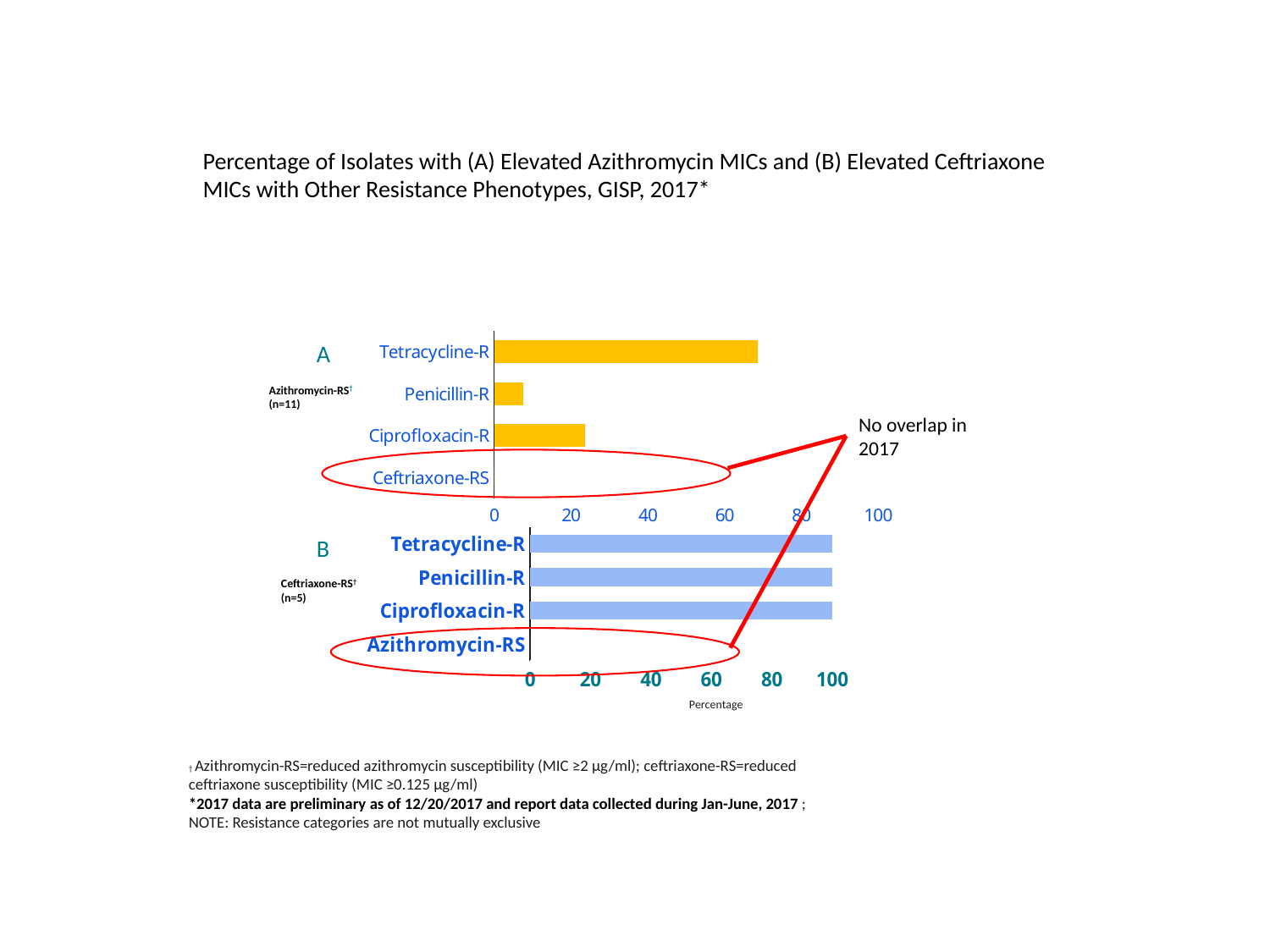
How many categories are shown in chart B (Ceftriaxone-RS)? 4 What type of chart is chart A (Azithromycin-RS)? Bar chart In chart A (Azithromycin-RS), what is the percentage for Ceftriaxone-RS? 0 What is the sample size (n) given for chart B (Ceftriaxone-RS)? n=5 In chart A (Azithromycin-RS), which category has the lowest percentage? Ceftriaxone-RS In chart A (Azithromycin-RS), which category has the highest percentage? Tetracycline-R In chart B (Ceftriaxone-RS), what is the percentage for Azithromycin-RS? 0 In chart A (Azithromycin-RS), is the value for Ciprofloxacin-R greater or less than 40? less In chart A (Azithromycin-RS), is the value for Tetracycline-R greater or less than 60? greater In chart A (Azithromycin-RS), which is larger, Ciprofloxacin-R or Penicillin-R? Ciprofloxacin-R In chart B (Ceftriaxone-RS), is the value for Penicillin-R greater or less than 80? greater